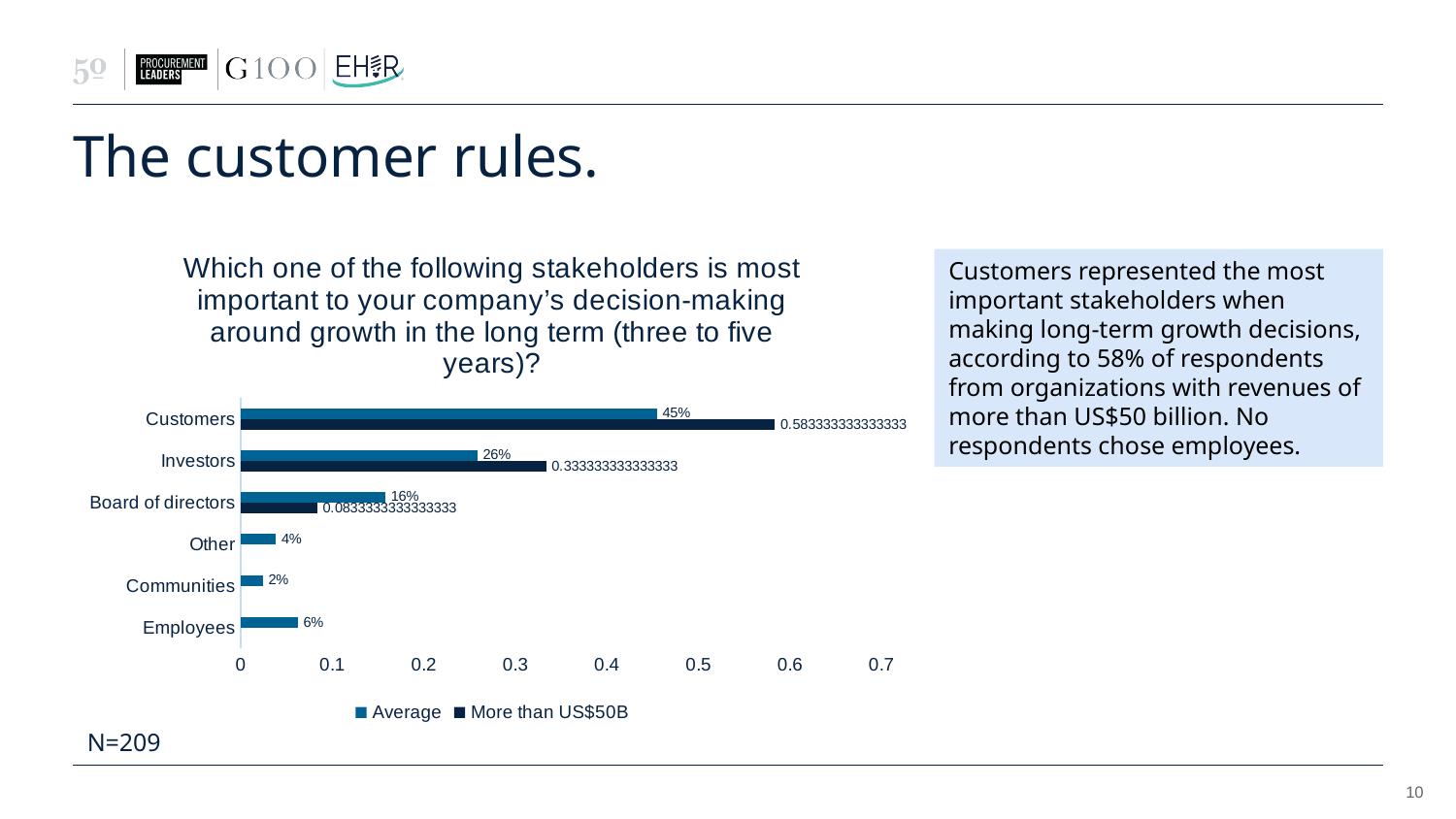
How many stakeholder categories are shown on the chart? 6 Is the More than US$50B value for Board of directors greater or less than 0.1? less Which category has the lowest Average value? Communities Which category has the highest Average value? Customers What is the Average value for Board of directors? 16% What is the More than US$50B value for Investors? 0.333333333333333 How many series does the legend list? 2 What kind of chart is shown on the slide? Bar chart What is the Average value for Customers? 45% What is the difference between the Average values for Customers and Investors? 19% What is the More than US$50B value for Customers? 0.583333333333333 Which has a larger Average value, Employees or Other? Employees